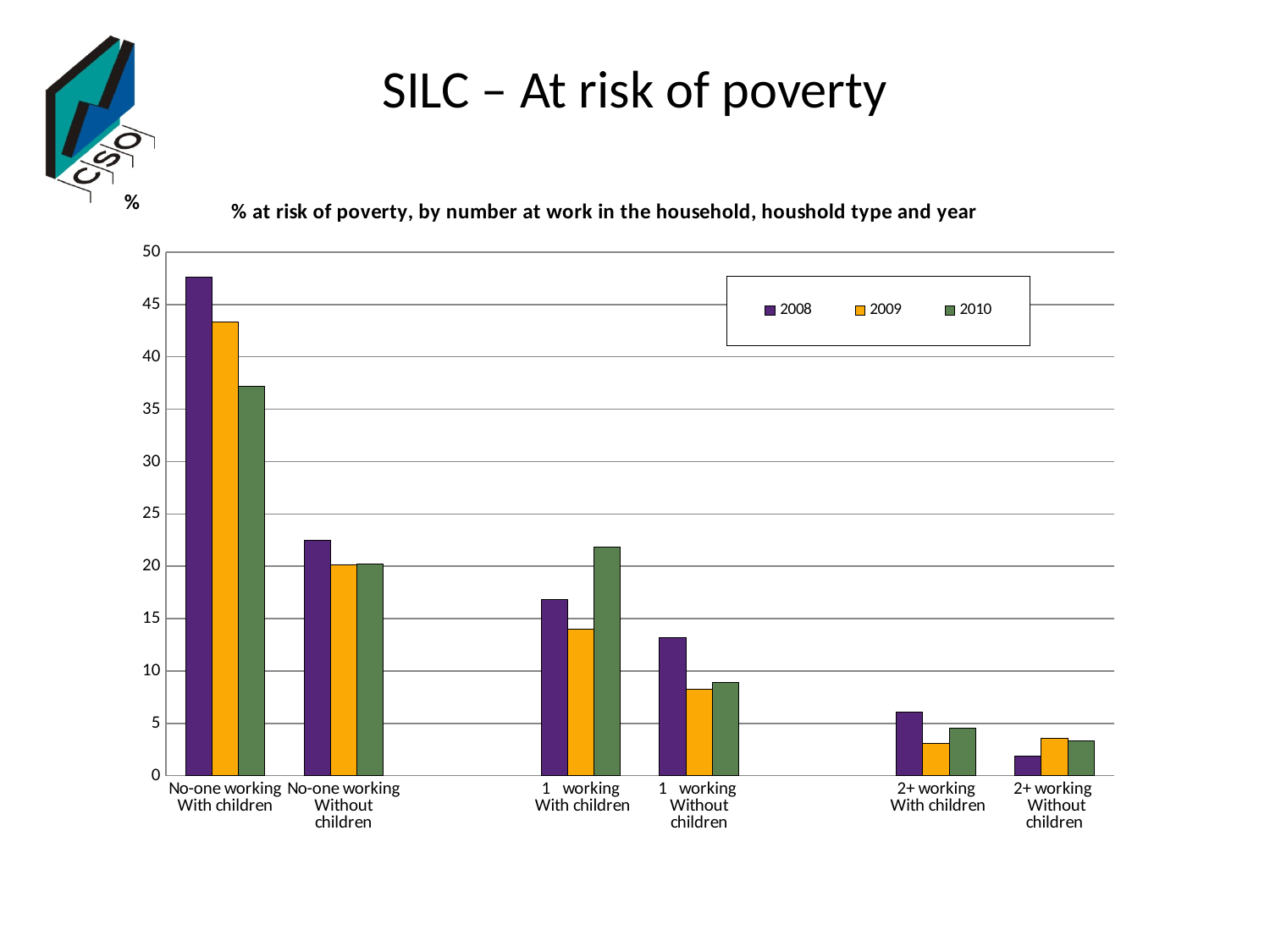
What are the entries in the chart's legend? 2008, 2009, 2010 For No-one working Without children, which year has the larger value, 2008 or 2009? 2008 Is the 2008 value for No-one working With children greater or less than 45? greater How many household categories are shown on the x axis? 6 For 1 working With children, which year has the larger value, 2008 or 2010? 2010 Is the 2010 value for 1 working With children greater or less than 20? greater What kind of chart is shown on the slide? bar chart For No-one working With children, do the values rise or fall from 2008 to 2010? fall Which category has the lowest value for 2008? 2+ working Without children Which category has the highest value for 2008? No-one working With children Is the 2010 value for No-one working With children greater or less than 40? less How many series does the legend list? 3